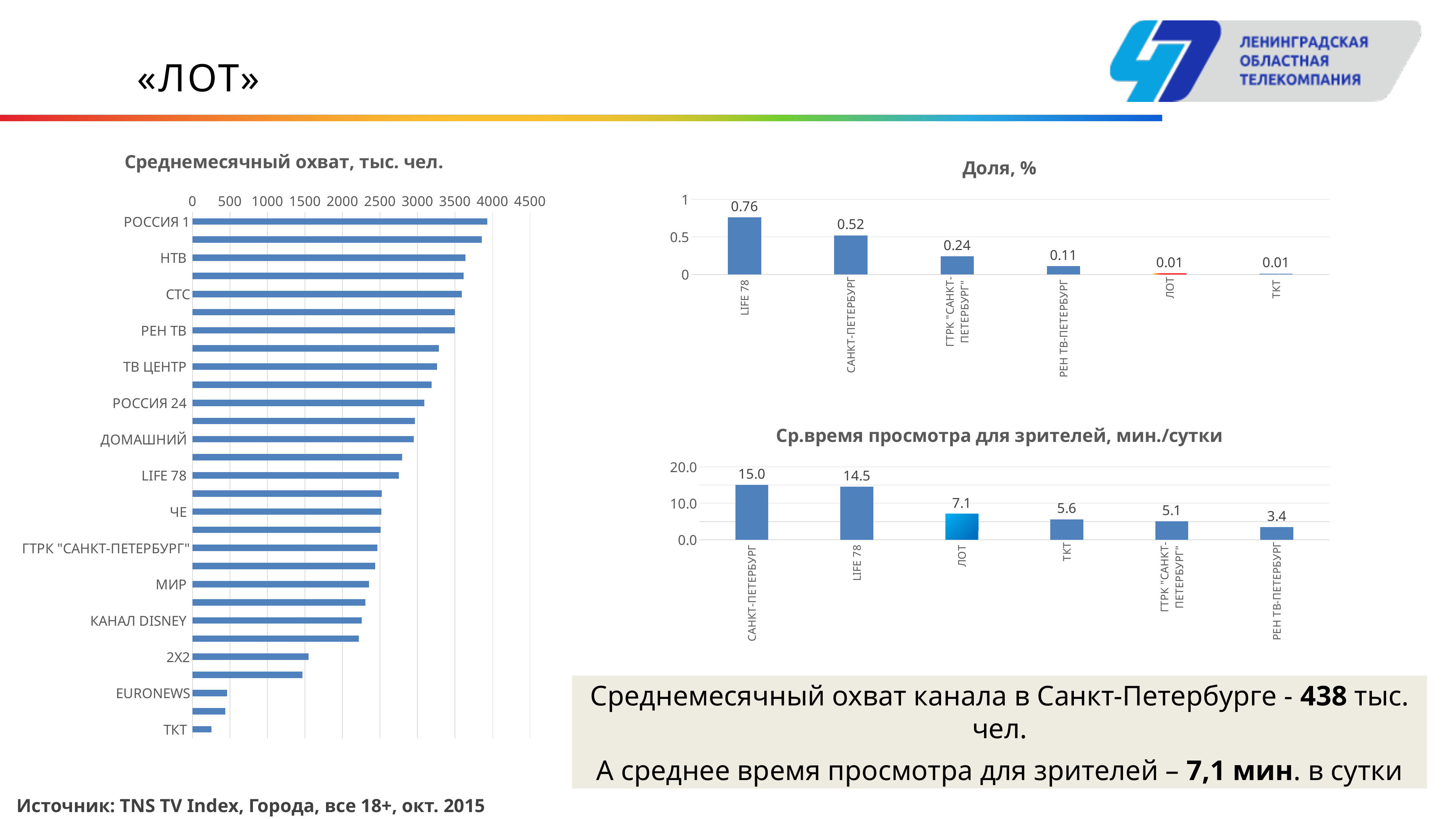
In the chart titled «Доля, %», how many categories are shown? 6 In the chart titled «Среднемесячный охват, тыс. чел.», is the value for ТКТ greater or less than 500? less In the chart titled «Ср.время просмотра для зрителей, мин./сутки», which is larger: ТКТ or ГТРК "САНКТ-ПЕТЕРБУРГ"? ТКТ In the chart titled «Ср.время просмотра для зрителей, мин./сутки», what is the difference between САНКТ-ПЕТЕРБУРГ and LIFE 78? 0.5 In the chart titled «Ср.время просмотра для зрителей, мин./сутки», what is the value for ЛОТ? 7.1 In the chart titled «Среднемесячный охват, тыс. чел.», is the value for РОССИЯ 1 greater or less than 3500? greater What kind of chart is the chart titled «Среднемесячный охват, тыс. чел.»? bar chart In the chart titled «Ср.время просмотра для зрителей, мин./сутки», which category has the lowest value? РЕН ТВ-ПЕТЕРБУРГ In the chart titled «Доля, %», what is the value for РЕН ТВ-ПЕТЕРБУРГ? 0.11 In the chart titled «Доля, %», what is the value for LIFE 78? 0.76 In the chart titled «Доля, %», which category has the highest value? LIFE 78 In the chart titled «Доля, %», what is the difference between LIFE 78 and САНКТ-ПЕТЕРБУРГ? 0.24